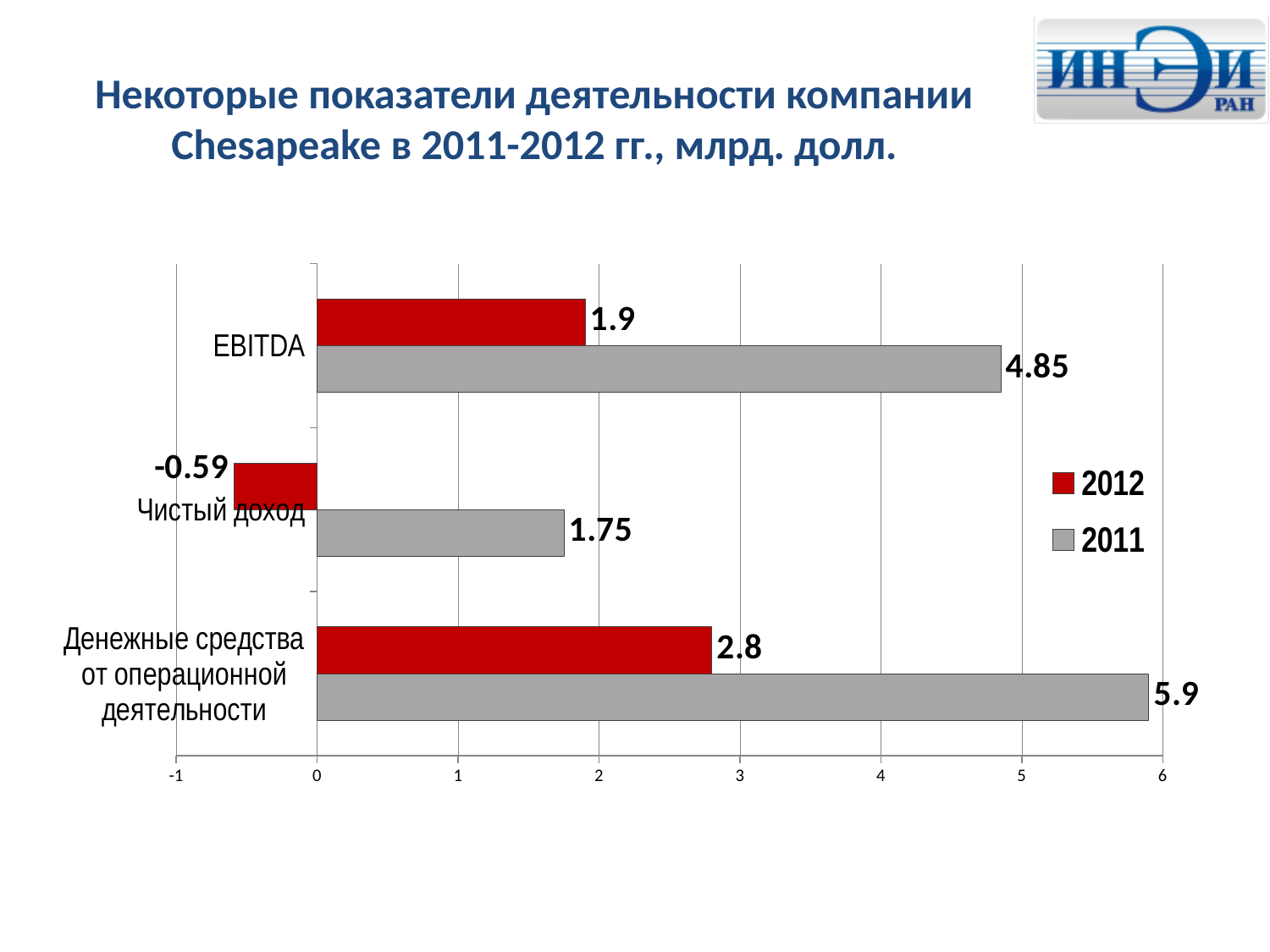
What is the 2012 value for EBITDA? 1.9 What is the 2012 value for Чистый доход? -0.59 What is the difference between the 2011 and 2012 values for Денежные средства от операционной деятельности? 3.1 Which category has the lowest 2012 value? Чистый доход What kind of chart is shown on the slide? Bar chart How many categories are shown on the chart? 3 What is the difference between the 2011 and 2012 values for EBITDA? 2.95 What is the 2011 value for EBITDA? 4.85 How many series does the legend list? 2 Which category has the highest 2011 value? Денежные средства от операционной деятельности Which is larger: the 2011 value for Чистый доход or the 2012 value for EBITDA? 2012 value for EBITDA What is the 2011 value for Денежные средства от операционной деятельности? 5.9